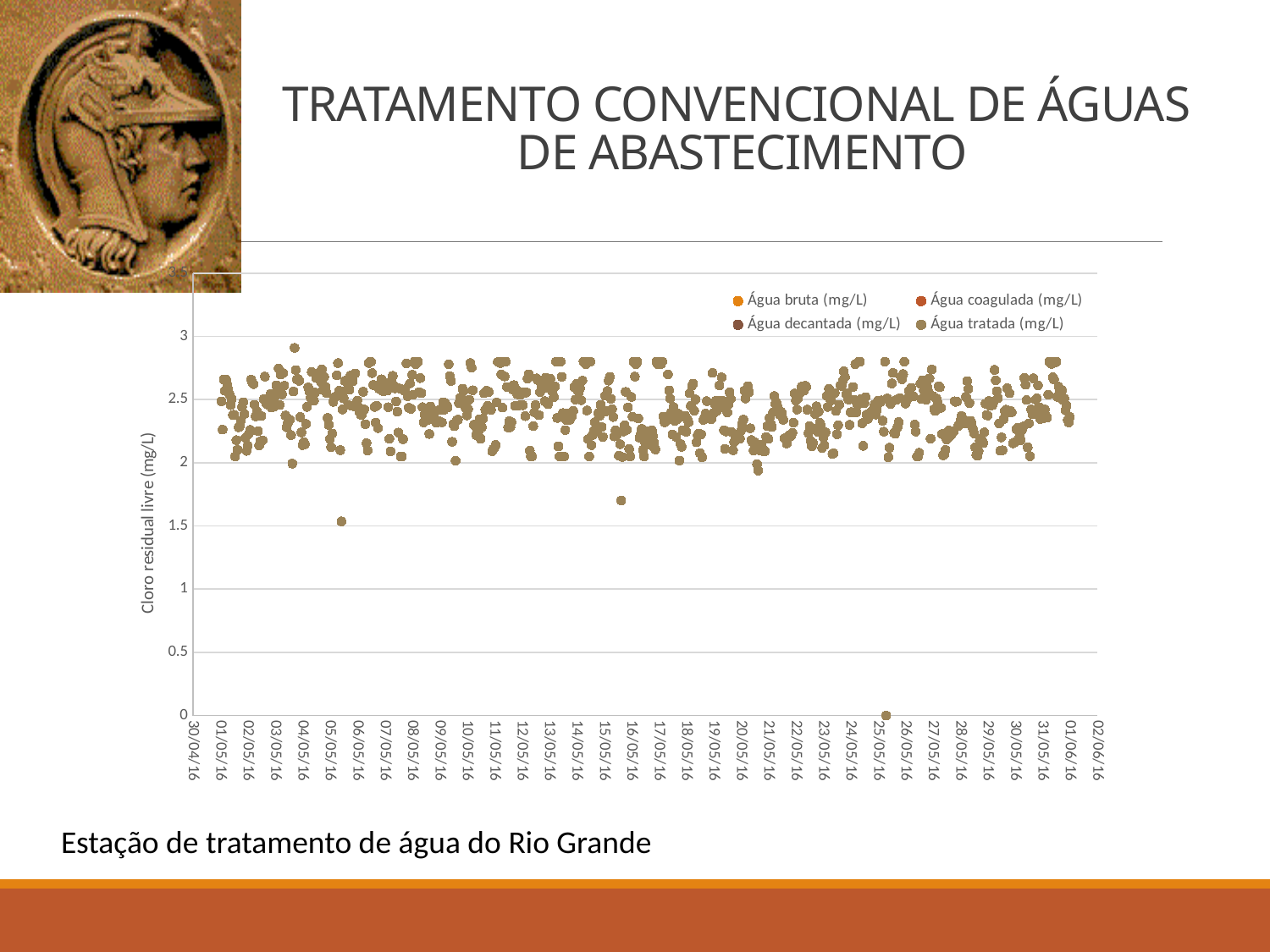
Is the isolated low point plotted near 05/05/16 greater or less than 1? greater What kind of chart is shown on the slide? scatter chart Which of the two isolated low points is lower: the one near 05/05/16 or the one near 15/05/16? the one near 05/05/16 Is the isolated low point plotted near 15/05/16 greater or less than 2? less Do the plotted values show a clear rising or falling trend across the dates on the x axis, or do they stay roughly level? roughly level How many series does the chart legend list? 4 Are the bulk of the plotted points greater or less than 2? greater What is the label of the vertical axis of the chart? Cloro residual livre (mg/L) Which series is listed last in the chart legend? Água tratada (mg/L)